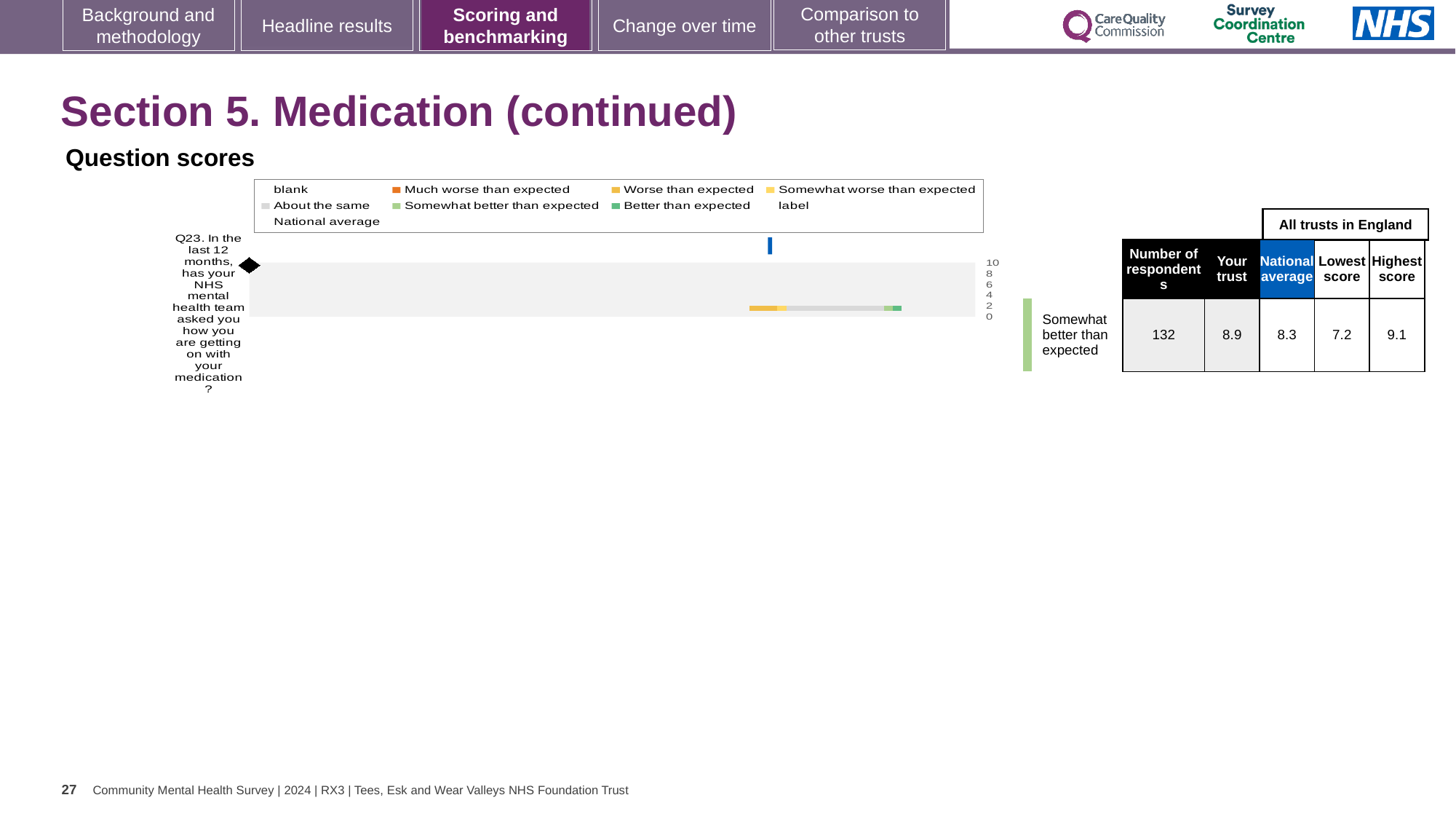
How many respondents answered Q23? 132 Which benchmark category is Q23 placed in? Somewhat better than expected Which is higher for Q23: the 'Your trust' score or the national average? Your trust What is the lowest score among all trusts in England for Q23? 7.2 What is the national average score for Q23? 8.3 What kind of chart is used to show the Q23 question score? Bar chart What colour represents 'Better than expected' in the chart legend? Green How many survey questions are plotted on the chart? 1 What is the highest score among all trusts in England for Q23? 9.1 What is the 'Your trust' score for Q23 (asked how you are getting on with your medication)? 8.9 What is the difference between the highest score and the lowest score for Q23? 1.9 By how much does the 'Your trust' score for Q23 exceed the national average? 0.6